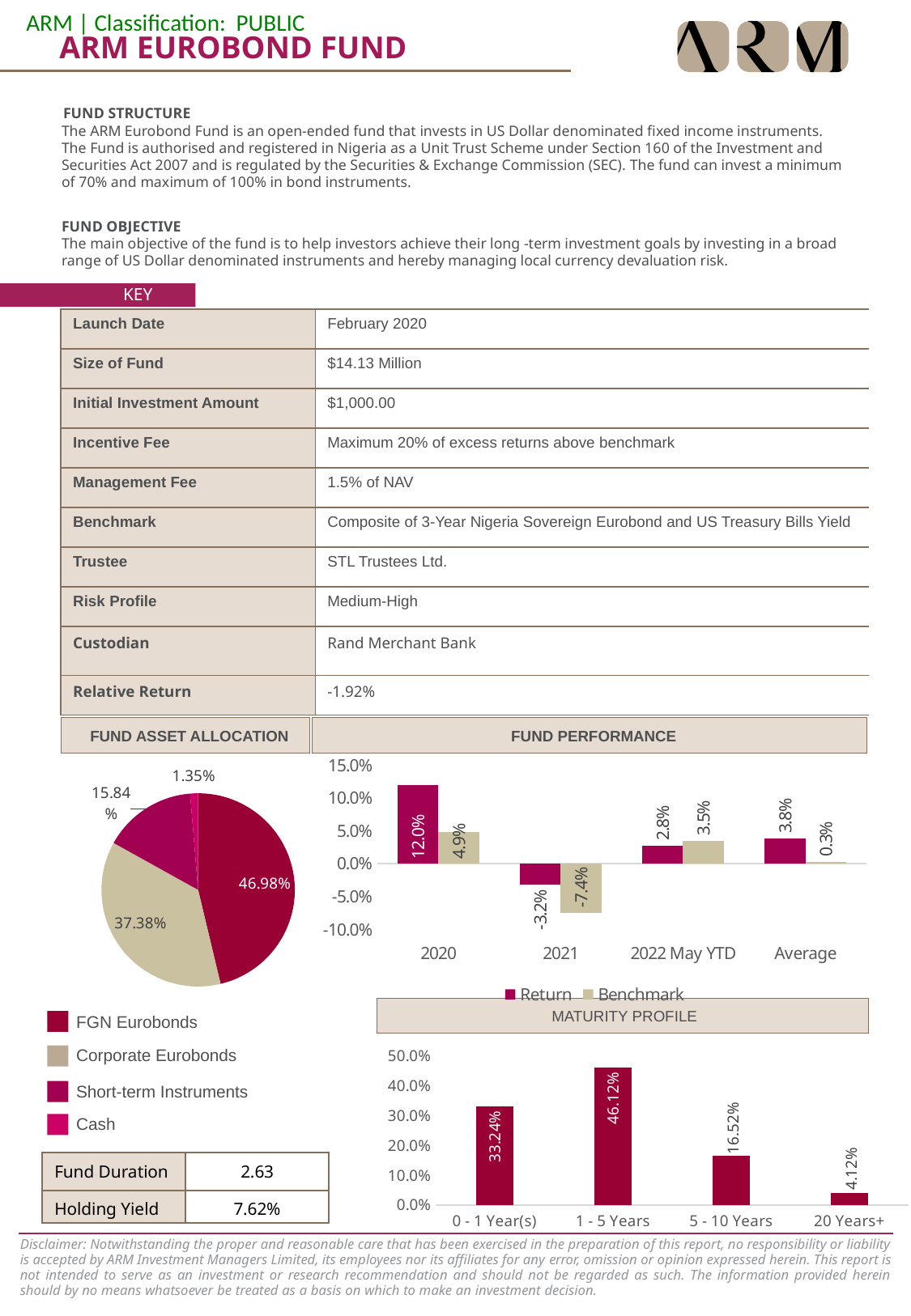
In the Fund Performance chart, what is the difference between the Return and the Benchmark for 2020? 7.1% In the Fund Performance chart, what is the Benchmark value for 2021? -7.4% In the Fund Performance chart, what is the Return for 2020? 12.0% What kind of chart is the Maturity Profile chart? Bar chart How many series does the legend of the Fund Performance chart list? 2 In the Fund Performance chart, for 2022 May YTD, which is larger: the Return or the Benchmark? Benchmark How many maturity buckets are shown in the Maturity Profile chart? 4 In the Fund Performance chart, which category has the highest Return? 2020 In the Fund Asset Allocation chart, what is the difference between the FGN Eurobonds share and the Short-term Instruments share? 31.14% In the Fund Asset Allocation chart, what share of the fund is in Corporate Eurobonds? 37.38% In the Maturity Profile chart, which maturity bucket has the lowest value? 20 Years+ In the Maturity Profile chart, what is the value for 1 - 5 Years? 46.12%